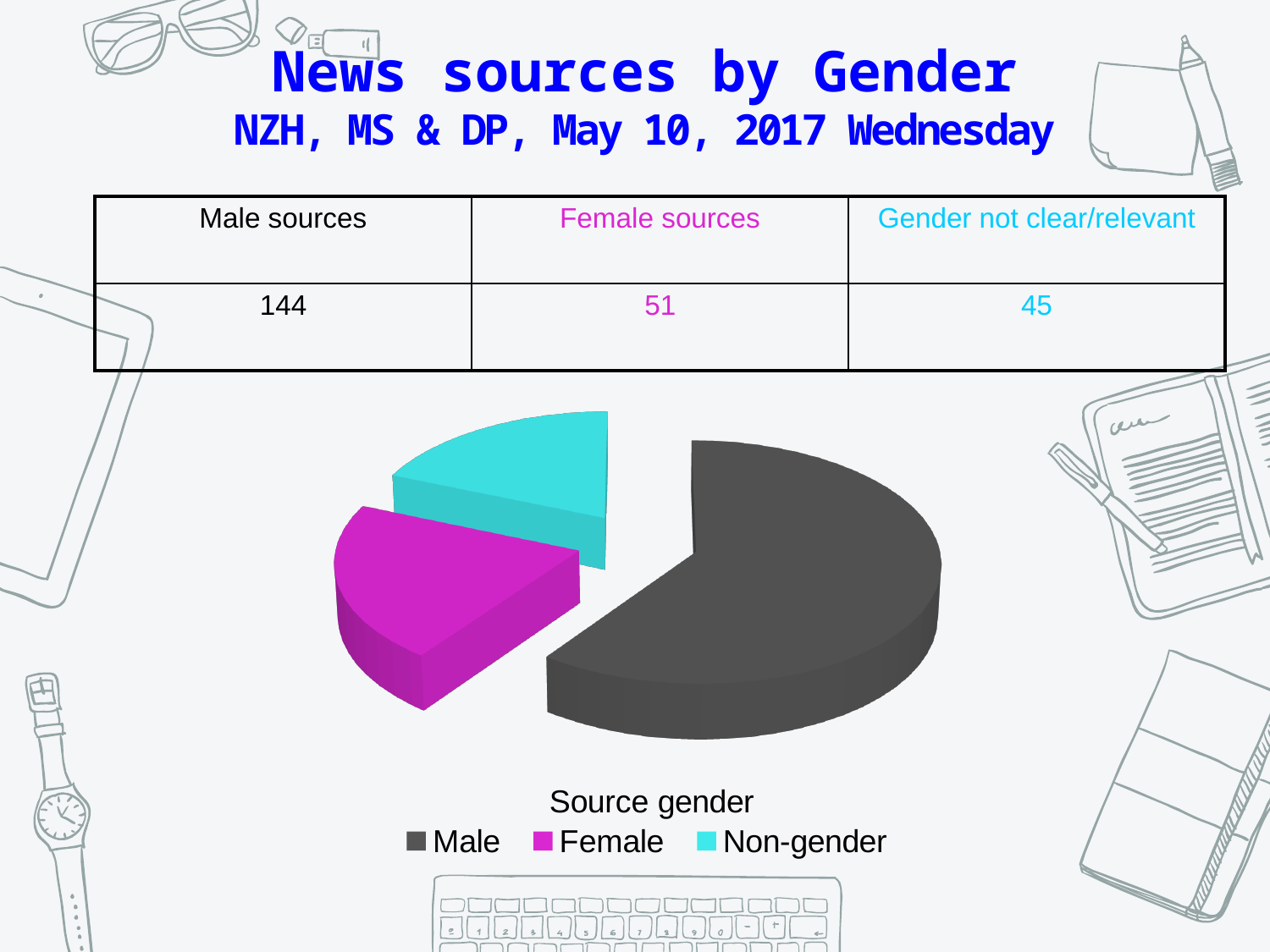
According to the table above the pie chart, how many sources had gender not clear/relevant? 45 Is the Male slice of the pie chart larger or smaller than the Female slice? Larger According to the table above the pie chart, how many male sources were counted? 144 What is the difference between the number of male sources and female sources shown in the table? 93 What kind of chart is shown on the slide? Pie chart Which slice of the pie chart is the smallest? Non-gender According to the table above the pie chart, how many female sources were counted? 51 What is the title shown beneath the pie chart? Source gender How many entries does the legend of the pie chart list? 3 How many slices does the pie chart have? 3 What is the total number of sources across all three categories in the table? 240 Which slice of the pie chart is the largest? Male